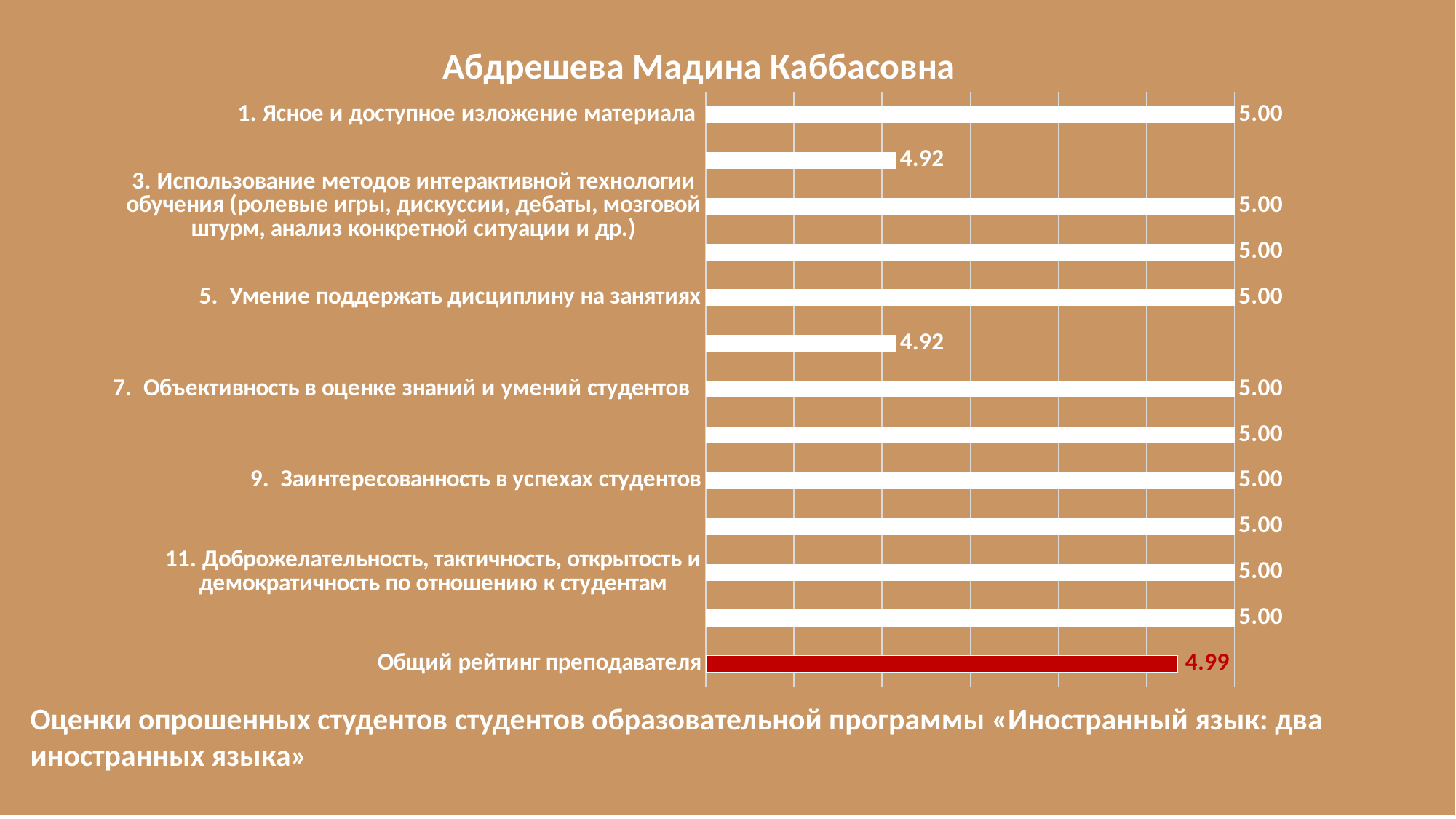
What is the title of the chart? Абдрешева Мадина Каббасовна What is the value for "5. Умение поддержать дисциплину на занятиях"? 5.00 How many bars have the value 4.92? 2 What type of chart is shown on the slide? bar chart What is the value for "11. Доброжелательность, тактичность, открытость и демократичность по отношению к студентам"? 5.00 What colour is the bar for "Общий рейтинг преподавателя"? red How many bars are plotted on the chart? 13 What is the lowest value shown on the chart? 4.92 What is the value for "Общий рейтинг преподавателя"? 4.99 What is the value for "1. Ясное и доступное изложение материала"? 5.00 What is the value for "7. Объективность в оценке знаний и умений студентов"? 5.00 What is the difference between the value for "9. Заинтересованность в успехах студентов" and the value for "Общий рейтинг преподавателя"? 0.01